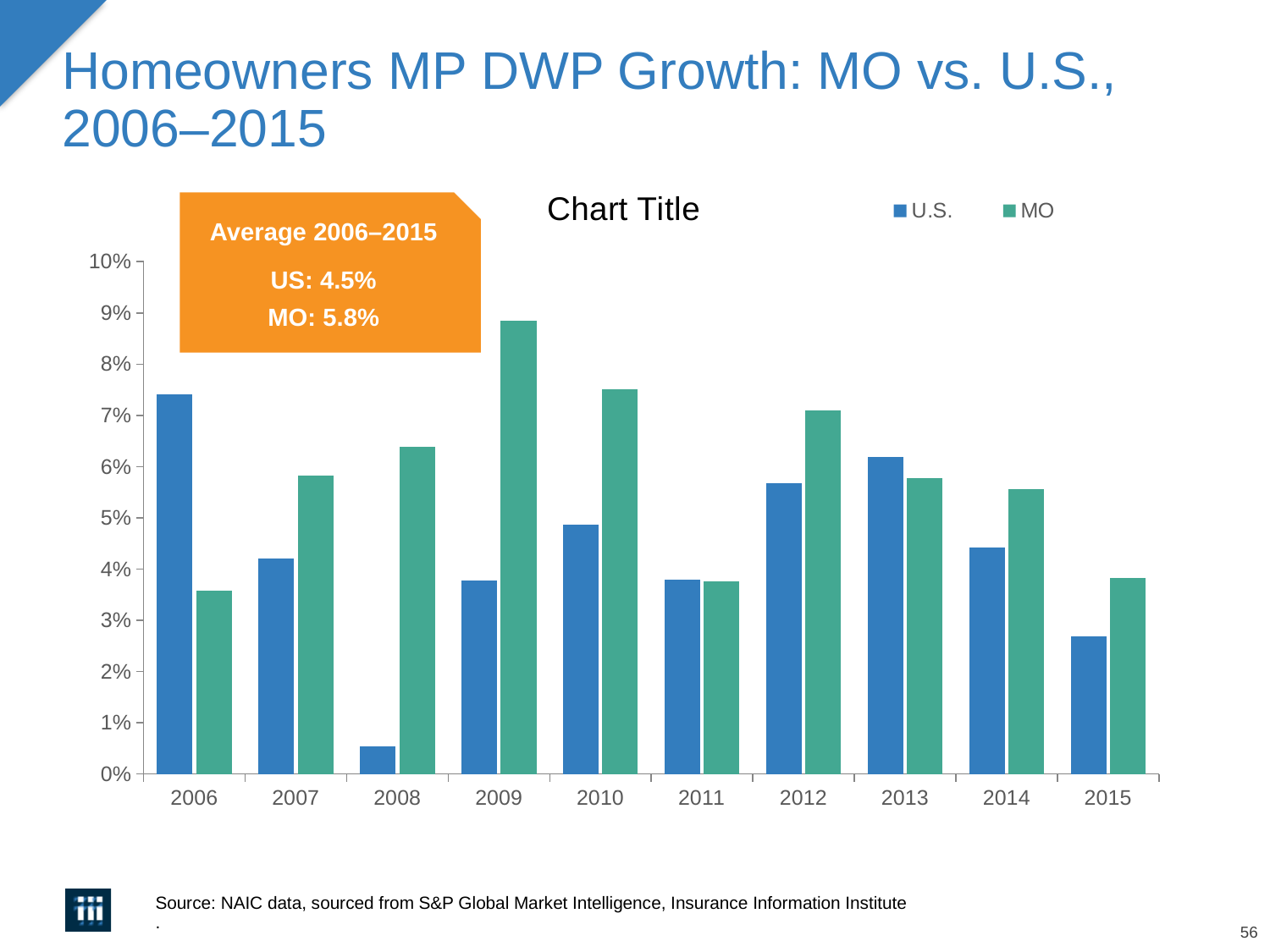
Is the MO value for 2009 greater or less than 8%? greater In 2008, which is larger, the U.S. bar or the MO bar? MO How many series does the legend list? 2 Is the U.S. value for 2008 greater or less than 1%? less How many years are shown on the x axis? 10 In 2013, which is larger, the U.S. bar or the MO bar? U.S. In which year is the MO bar highest? 2009 Is the U.S. value for 2006 greater or less than 7%? greater In which year is the U.S. bar lowest? 2008 According to the callout box, what is the MO average for 2006–2015? 5.8% What kind of chart is shown on the slide? bar chart In which year is the U.S. bar highest? 2006